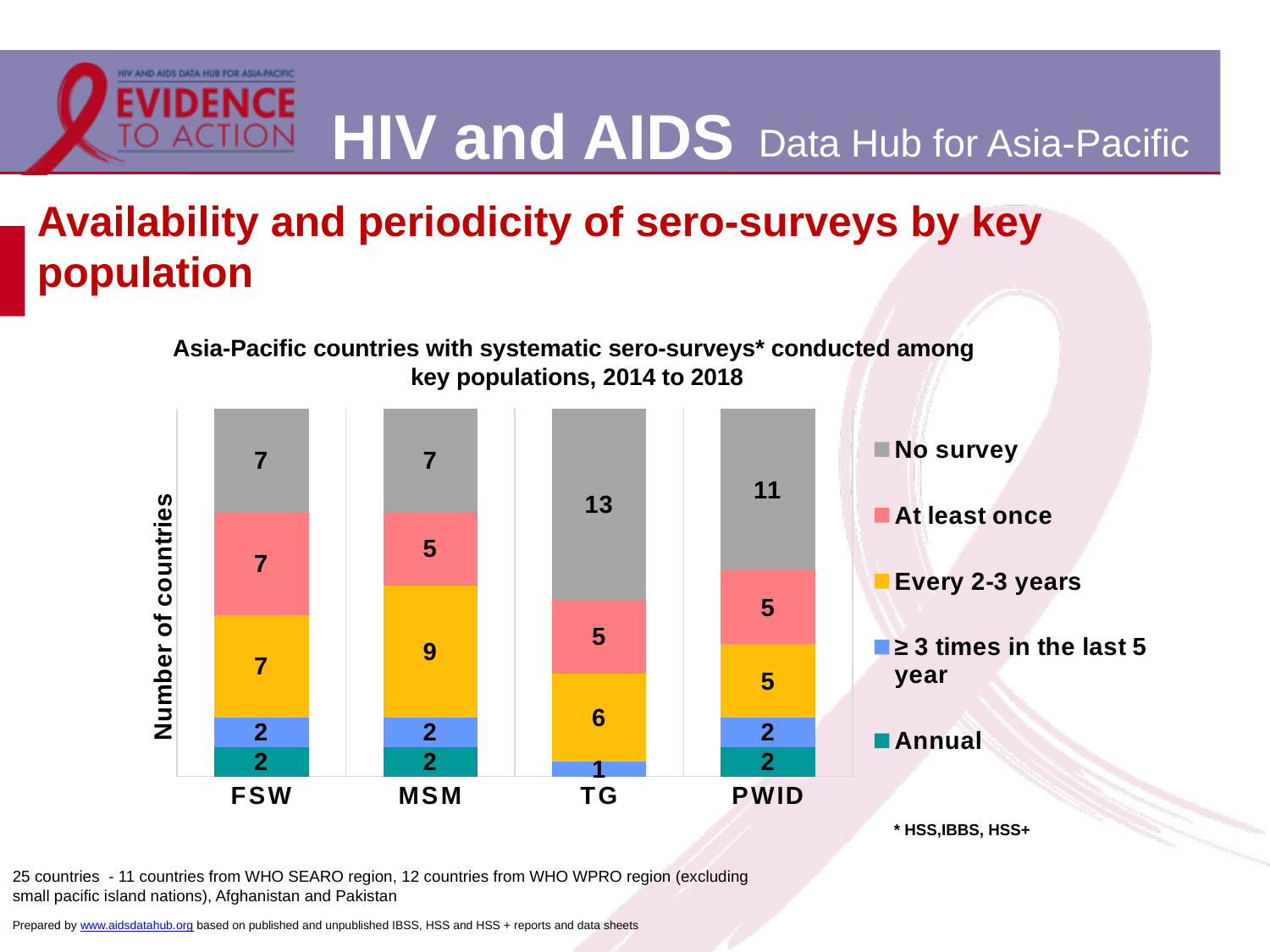
What type of chart is shown on the slide? Stacked bar chart What is the difference between the 'No survey' values for TG and FSW? 6 What is the 'No survey' value for TG? 13 Which is larger, the 'Every 2-3 years' value for MSM or for PWID? MSM Which key population has the highest 'No survey' value? TG What is the 'Every 2-3 years' value for MSM? 9 Which colour represents 'No survey' in the chart? Gray How many series does the legend list? 5 Which key population has the lowest '≥ 3 times in the last 5 year' value? TG What is the 'At least once' value for PWID? 5 What is the total of the stacked bar for PWID? 25 How many key population categories are shown on the x axis? 4